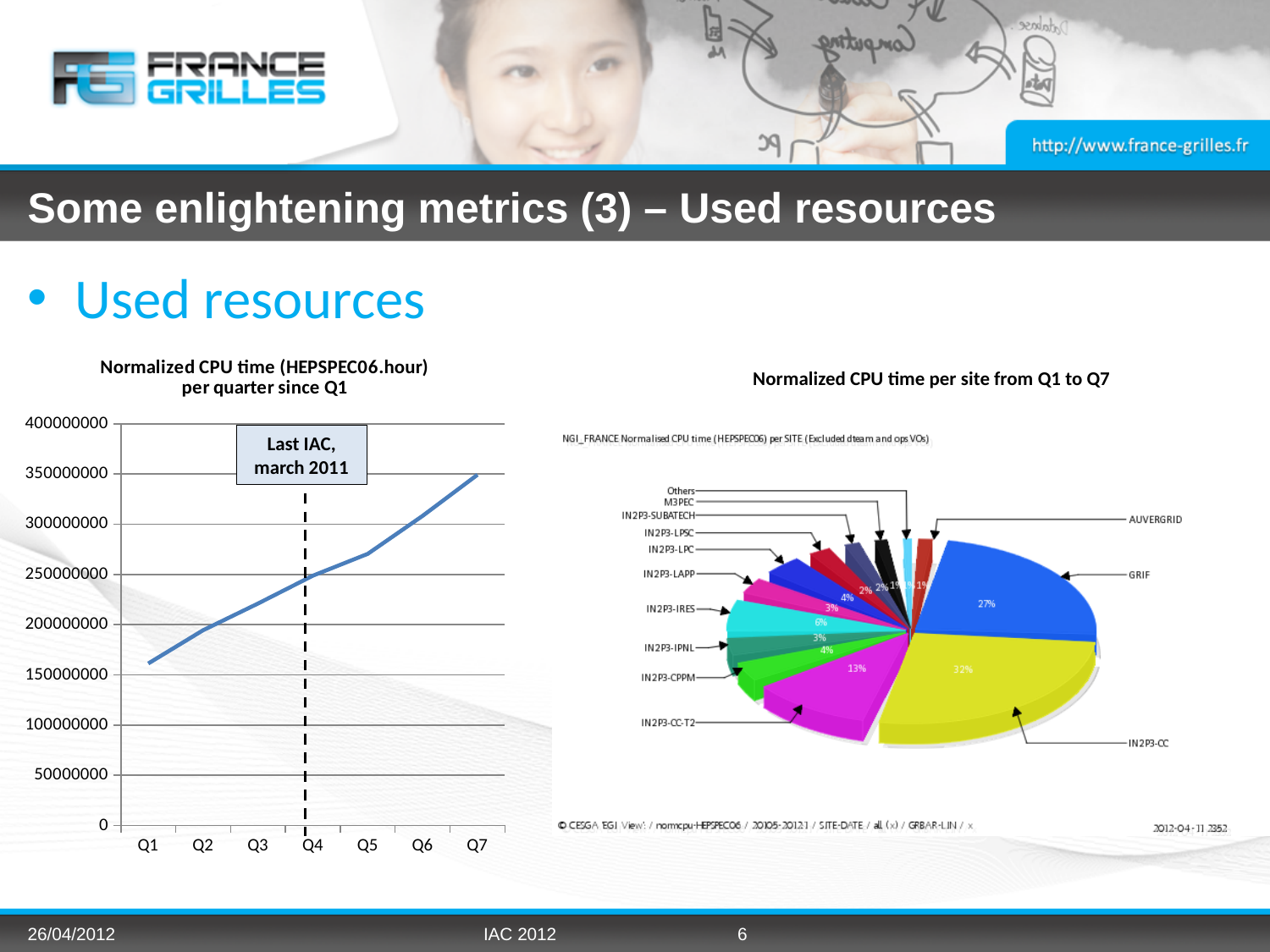
What kind of chart is the left chart titled 'Normalized CPU time (HEPSPEC06.hour) per quarter since Q1'? line chart How many quarters are plotted on the x axis of the left line chart? 7 In the right pie chart, which site has the largest share? IN2P3-CC In the left line chart, is the value for Q1 greater or less than 150000000? greater In the left line chart, is the value for Q3 greater or less than 250000000? less In the left line chart, is the value for Q7 greater or less than 400000000? less In the right pie chart, what share does IN2P3-CC have? 32% What kind of chart is the right chart titled 'Normalized CPU time per site from Q1 to Q7'? pie chart In the left line chart, which quarter has the highest value? Q7 In the right pie chart, which is larger, the share of GRIF or the share of IN2P3-CC-T2? GRIF In the left line chart, do the values rise or fall from Q1 to Q7? rise